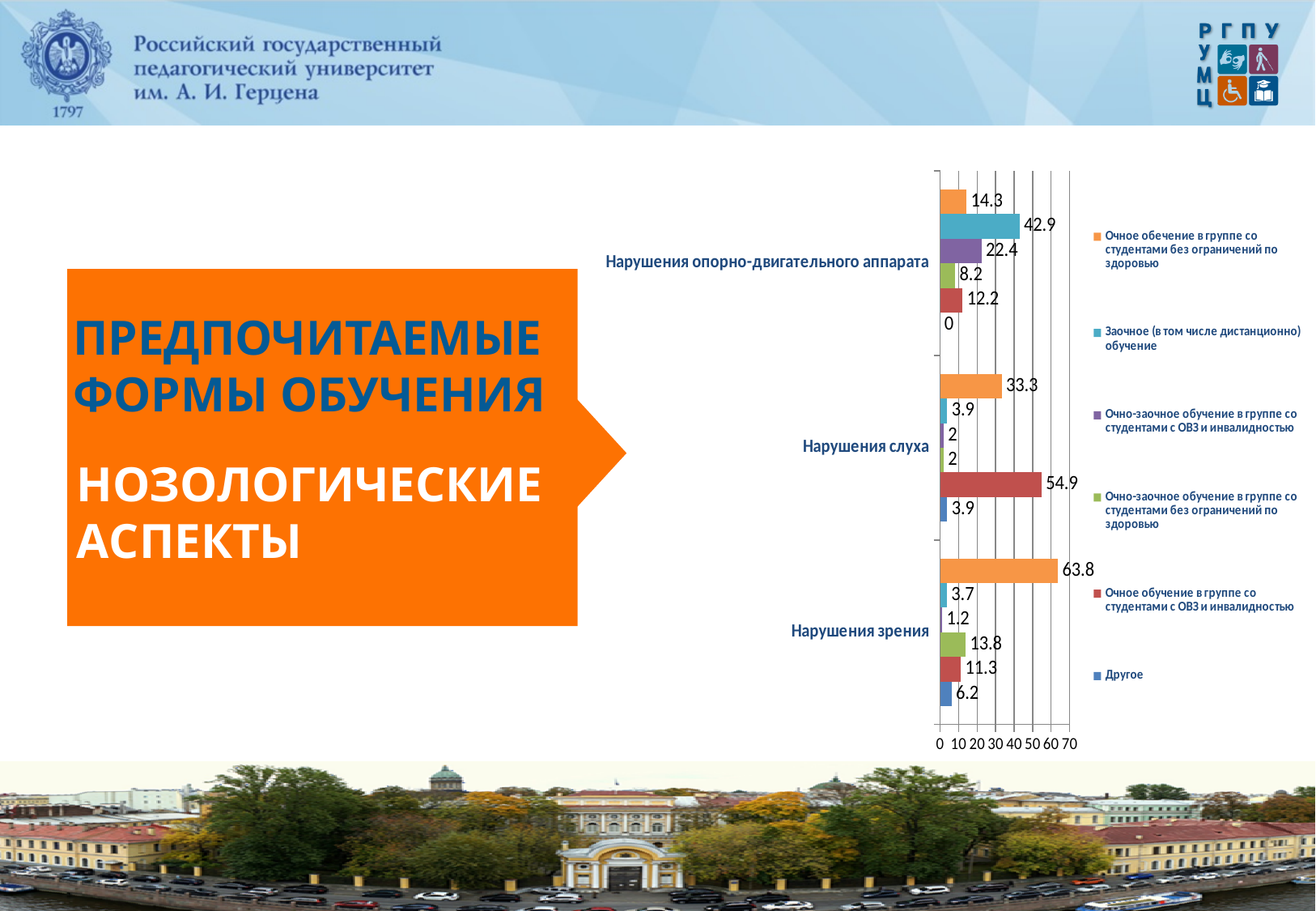
What is the value for 'Заочное (в том числе дистанционно) обучение' in the category 'Нарушения опорно-двигательного аппарата'? 42.9 What is the value for 'Очное обечение в группе со студентами без ограничений по здоровью' in the category 'Нарушения зрения'? 63.8 What is the value for 'Очное обучение в группе со студентами с ОВЗ и инвалидностью' in the category 'Нарушения слуха'? 54.9 What is the difference between the values for 'Заочное (в том числе дистанционно) обучение' and 'Очно-заочное обучение в группе со студентами с ОВЗ и инвалидностью' in the category 'Нарушения опорно-двигательного аппарата'? 20.5 What is the maximum value shown on the chart's horizontal axis? 70 What type of chart is shown on the slide? bar chart How many series does the chart legend list? 6 Which series has the highest value in the category 'Нарушения зрения'? Очное обечение в группе со студентами без ограничений по здоровью What is the value for 'Другое' in the category 'Нарушения опорно-двигательного аппарата'? 0 Which series has the lowest value in the category 'Нарушения зрения'? Очно-заочное обучение в группе со студентами с ОВЗ и инвалидностью How many categories (nosological groups) are shown on the chart? 3 In the category 'Нарушения слуха', which is larger: the value for 'Очное обечение в группе со студентами без ограничений по здоровью' or for 'Очное обучение в группе со студентами с ОВЗ и инвалидностью'? Очное обучение в группе со студентами с ОВЗ и инвалидностью